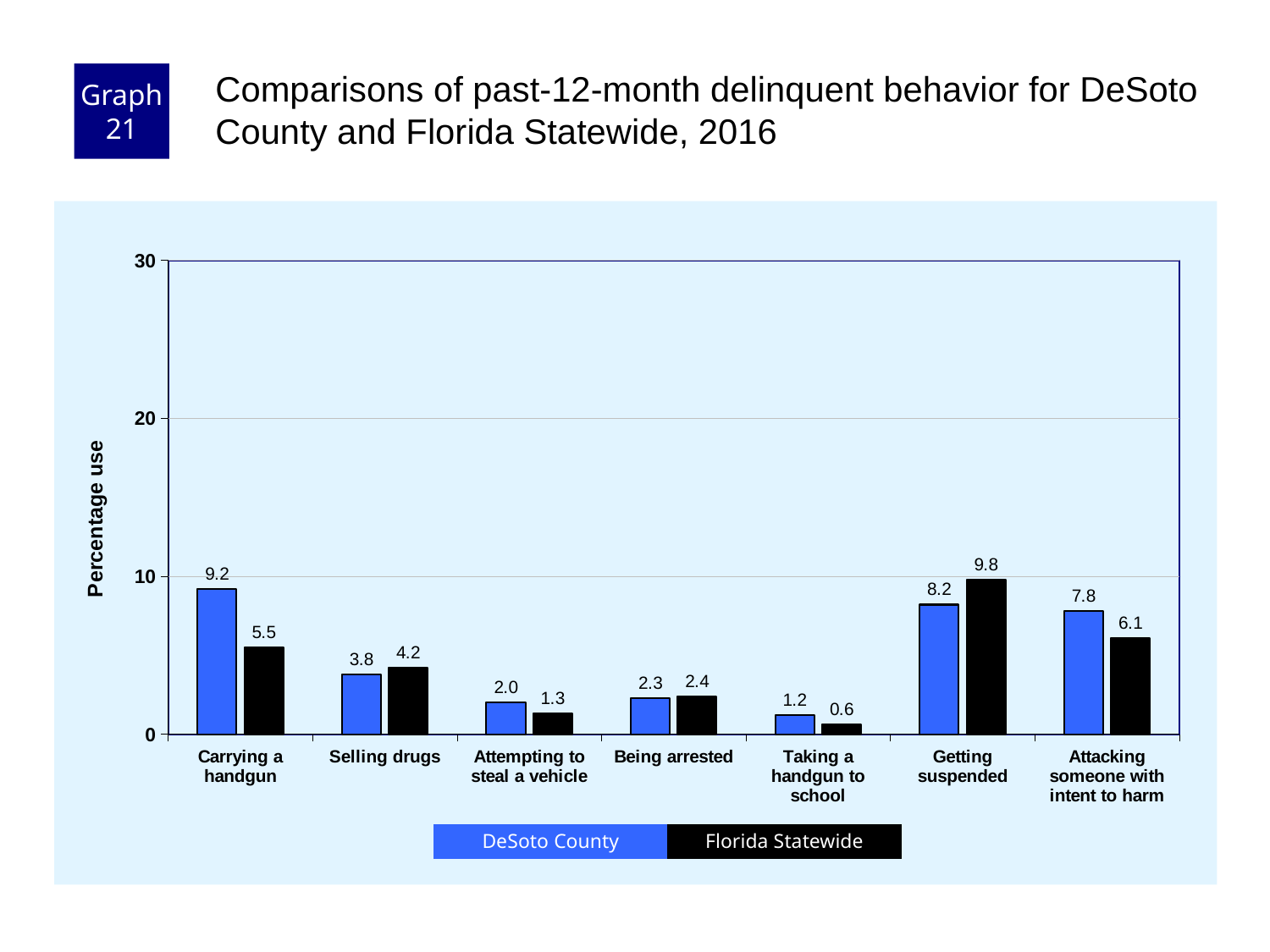
Which is larger for Attacking someone with intent to harm: DeSoto County or Florida Statewide? DeSoto County How many categories are shown on the x axis? 7 What is the Florida Statewide value for Getting suspended? 9.8 What kind of chart is shown on the slide? bar chart Which category has the highest DeSoto County value? Carrying a handgun How many series does the legend list? 2 What is the DeSoto County value for Carrying a handgun? 9.2 Is the Florida Statewide value for Getting suspended greater or less than 10? less What is the difference between the DeSoto County and Florida Statewide values for Carrying a handgun? 3.7 What is the Florida Statewide value for Taking a handgun to school? 0.6 Which category has the lowest Florida Statewide value? Taking a handgun to school What is the difference between the Florida Statewide and DeSoto County values for Getting suspended? 1.6